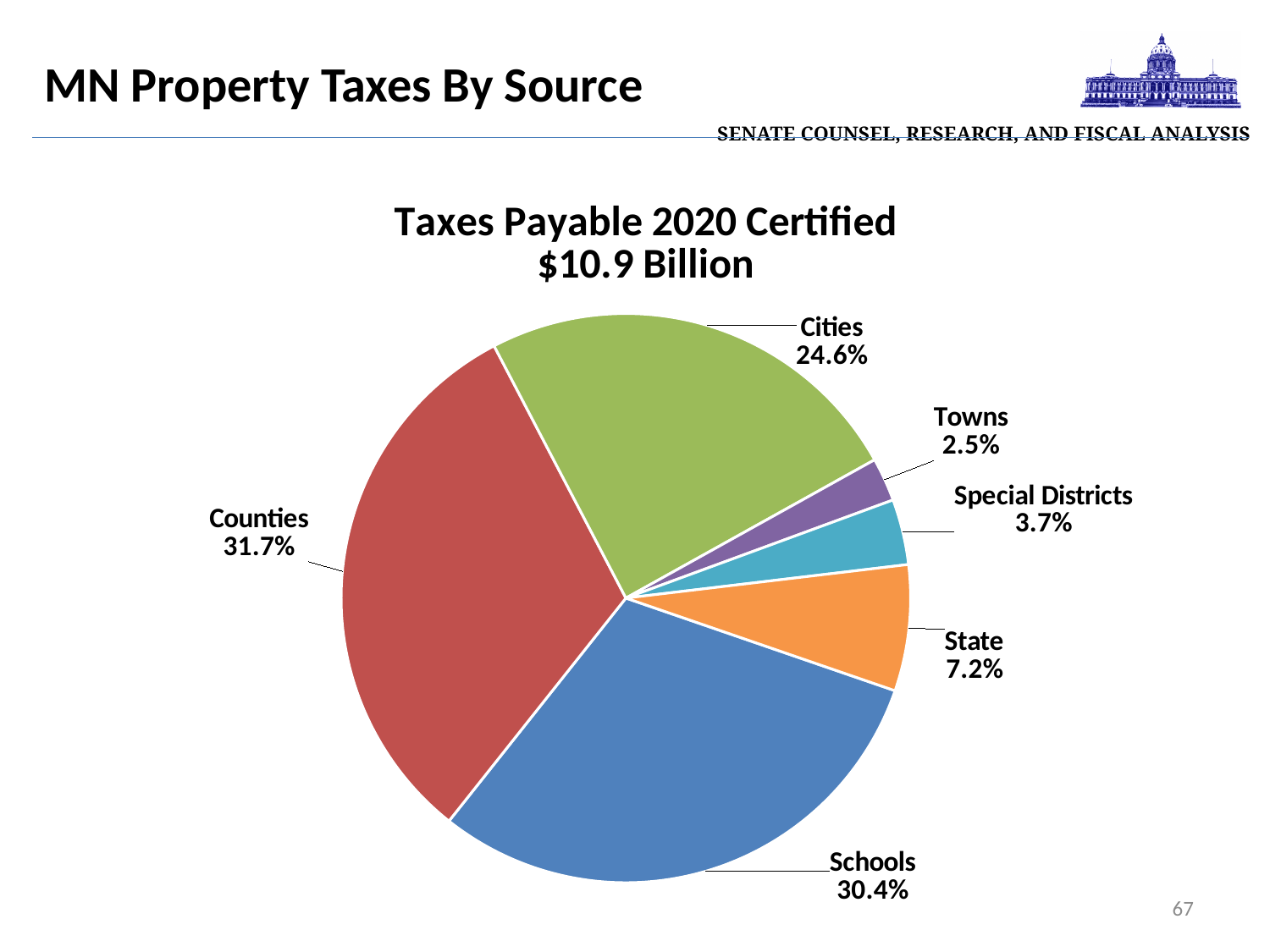
Which category has the smallest share of the pie? Towns What share of the pie is Towns? 2.5% What kind of chart is shown on the slide? Pie chart How many categories are shown in the pie chart? 6 What is the difference in percentage points between Counties and Schools? 1.3 Which is larger, the share for Special Districts or the share for State? State Which category has the largest share of the pie? Counties What total dollar amount is given in the chart title? $10.9 Billion What share of the pie is Cities? 24.6% What share of the pie is Schools? 30.4% What share of the pie is Counties? 31.7% What share of the pie is State? 7.2%